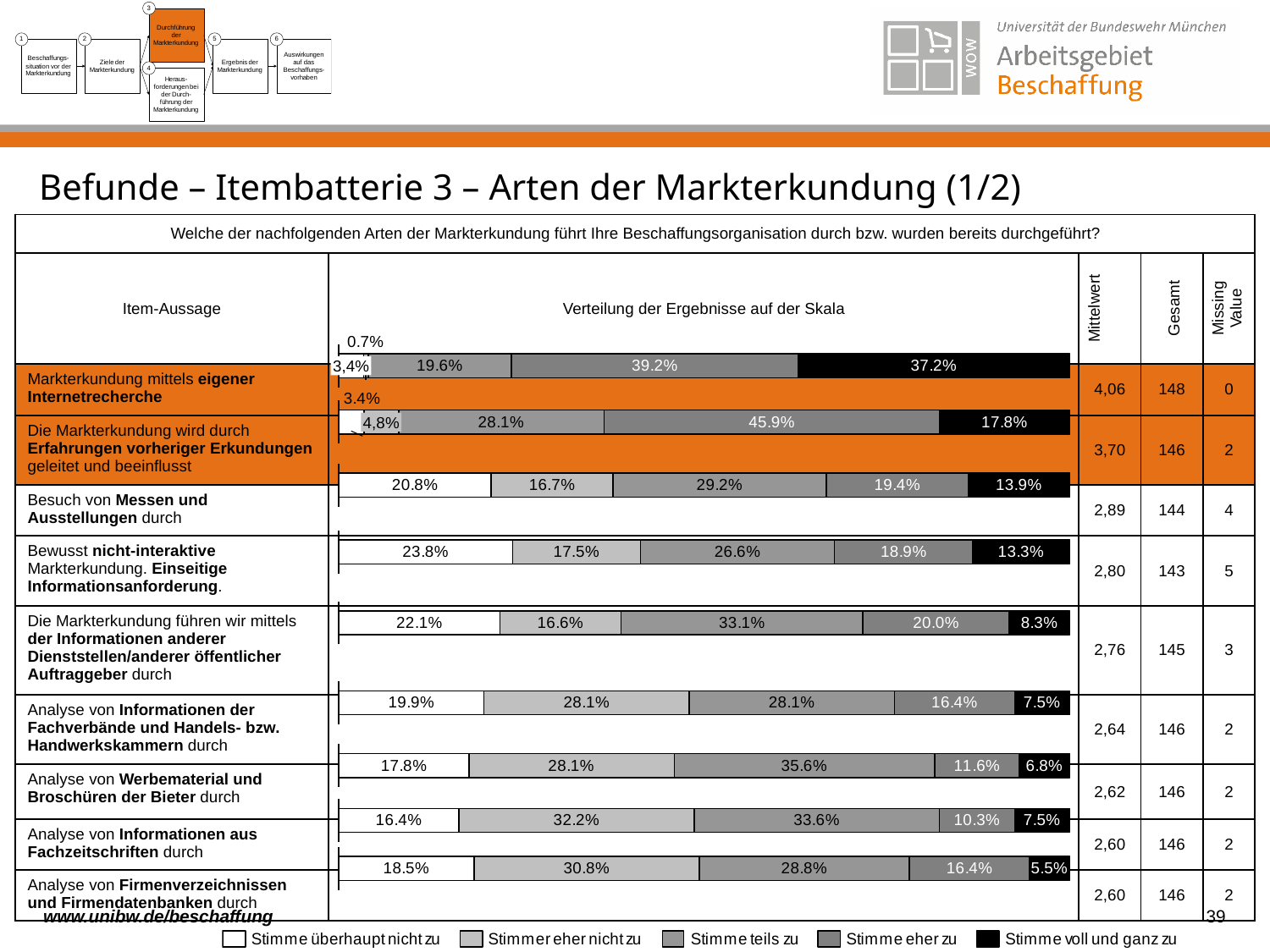
What is the difference between the 'Stimme teils zu' share for 'Analyse von Werbematerial und Broschüren der Bieter durch' (35.6%) and for 'Besuch von Messen und Ausstellungen durch' (29.2%)? 6.4% What is the 'Stimme teils zu' share for 'Die Markterkundung wird durch Erfahrungen vorheriger Erkundungen geleitet und beeinflusst'? 45.9% What is the 'Stimme überhaupt nicht zu' share for 'Bewusst nicht-interaktive Markterkundung. Einseitige Informationsanforderung'? 23.8% Which item has the lowest 'Stimme voll und ganz zu' share? Analyse von Firmenverzeichnissen und Firmendatenbanken durch What is the 'Stimme voll und ganz zu' share for 'Markterkundung mittels eigener Internetrecherche'? 37.2% Which is larger: the 'Stimme eher zu' share for 'Besuch von Messen und Ausstellungen durch' or for 'Analyse von Werbematerial und Broschüren der Bieter durch'? Besuch von Messen und Ausstellungen durch What is the 'Stimmer eher nicht zu' share for 'Analyse von Informationen aus Fachzeitschriften durch'? 32.2% Which legend entry is shown with a black fill? Stimme voll und ganz zu What kind of chart is shown on the slide? stacked bar chart How many item statements (bars) are plotted in the chart? 9 Which item has the highest 'Stimme voll und ganz zu' share? Markterkundung mittels eigener Internetrecherche How many series does the legend list? 5